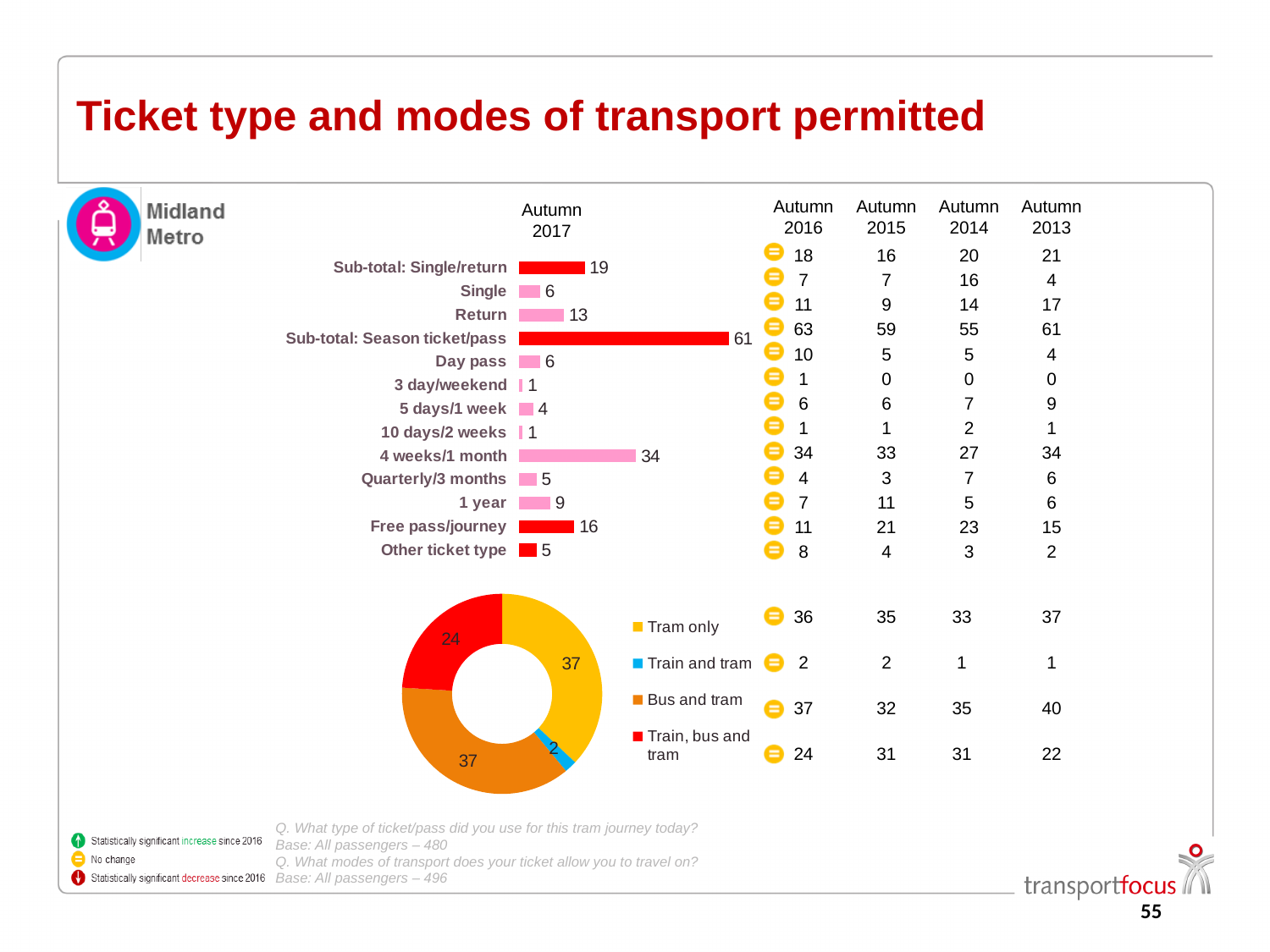
How many ticket type categories are shown in the bar chart? 13 How many entries does the legend of the doughnut chart list? 4 In the bar chart of ticket types, what is the value for 4 weeks/1 month in Autumn 2017? 34 In the bar chart of ticket types, what is the difference between Return and Single? 7 In the doughnut chart, what colour represents Bus and tram? Orange In the bar chart of ticket types, which is larger, Day pass or 1 year? 1 year In the doughnut chart of modes of transport permitted, which category has the lowest value? Train and tram In the bar chart of ticket types, what is the value for Free pass/journey in Autumn 2017? 16 In the doughnut chart of modes of transport permitted, what is the value for Train, bus and tram? 24 In the bar chart of ticket types, what is the value for Sub-total: Season ticket/pass in Autumn 2017? 61 What kind of chart is used to show ticket types for Autumn 2017? Bar chart In the bar chart of ticket types, which category has the highest value? Sub-total: Season ticket/pass